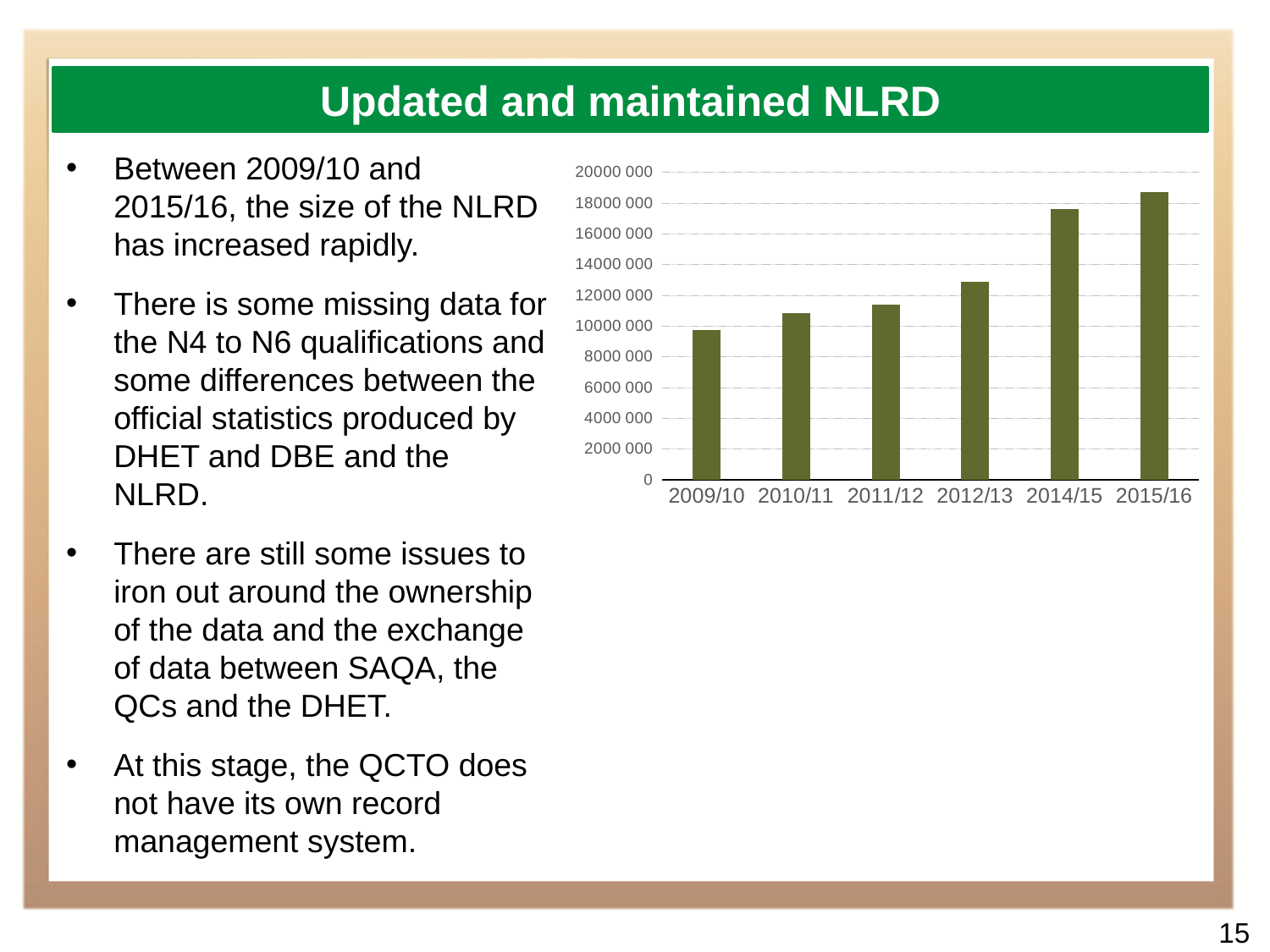
Is the value for 2012/13 greater or less than 14000 000? less Is the value for 2015/16 greater or less than 18000 000? greater How many categories are shown on the x axis of the chart? 6 Which year has the highest value in the chart? 2015/16 What colour are the bars in the chart? green Is the value for 2010/11 greater or less than 10000 000? greater Which year has the lowest value in the chart? 2009/10 What kind of chart is shown on the slide? bar chart Do the values rise or fall from 2009/10 to 2015/16? rise Which is larger, the value for 2014/15 or the value for 2012/13? 2014/15